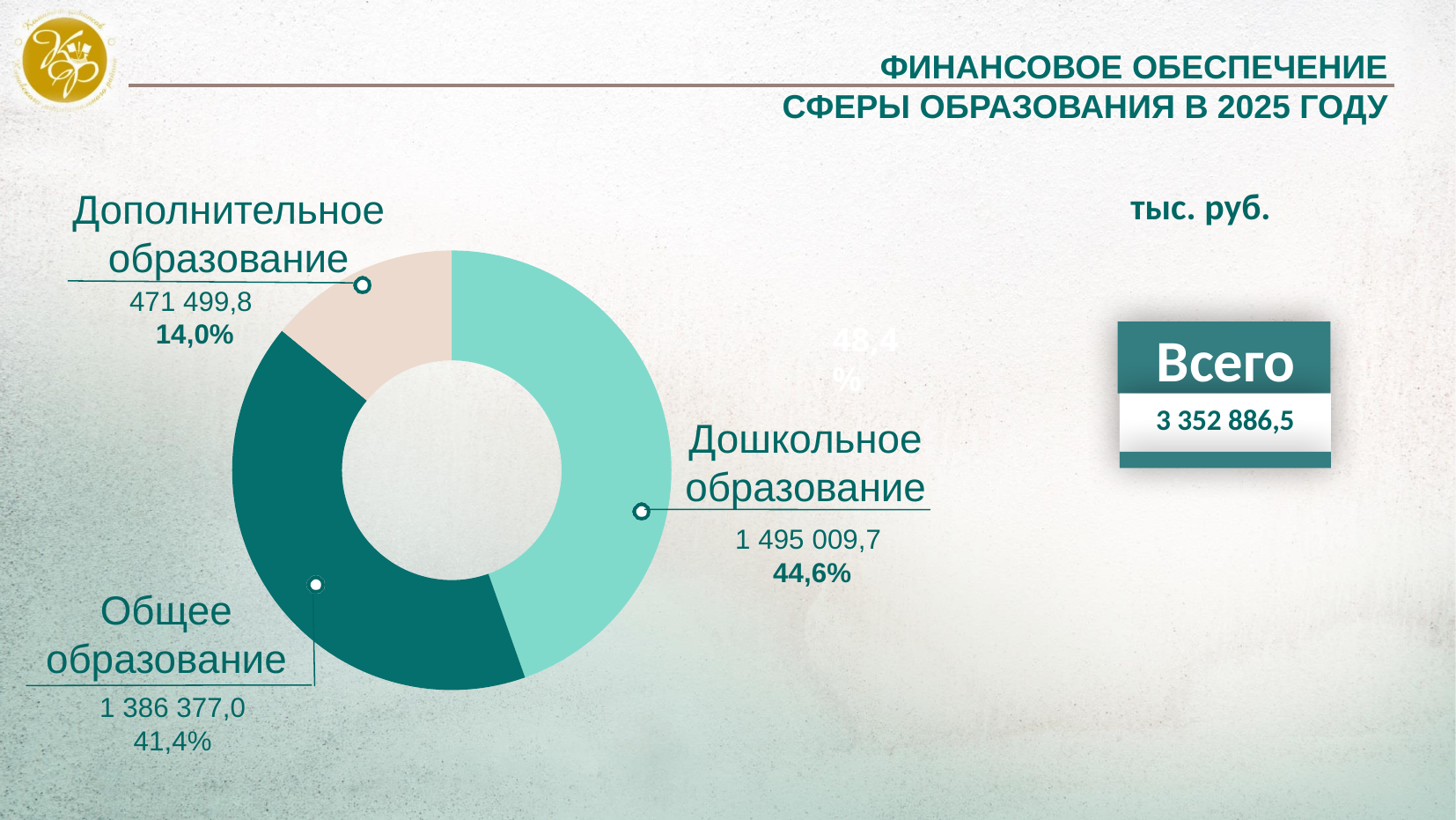
How many categories are shown in the chart? 3 What share of the total does Дополнительное образование account for? 14,0% What total (Всего) is shown on the slide? 3 352 886,5 What is the value for Дошкольное образование? 1 495 009,7 What share of the total does Дошкольное образование account for? 44,6% What is the difference between the values for Дошкольное образование and Общее образование? 108 632,7 What is the value for Дополнительное образование? 471 499,8 Which category has the smallest value? Дополнительное образование What kind of chart is shown on the slide? Donut (pie) chart Which category has the largest value? Дошкольное образование What is the value for Общее образование? 1 386 377,0 Which is larger, the value for Общее образование or the value for Дополнительное образование? Общее образование